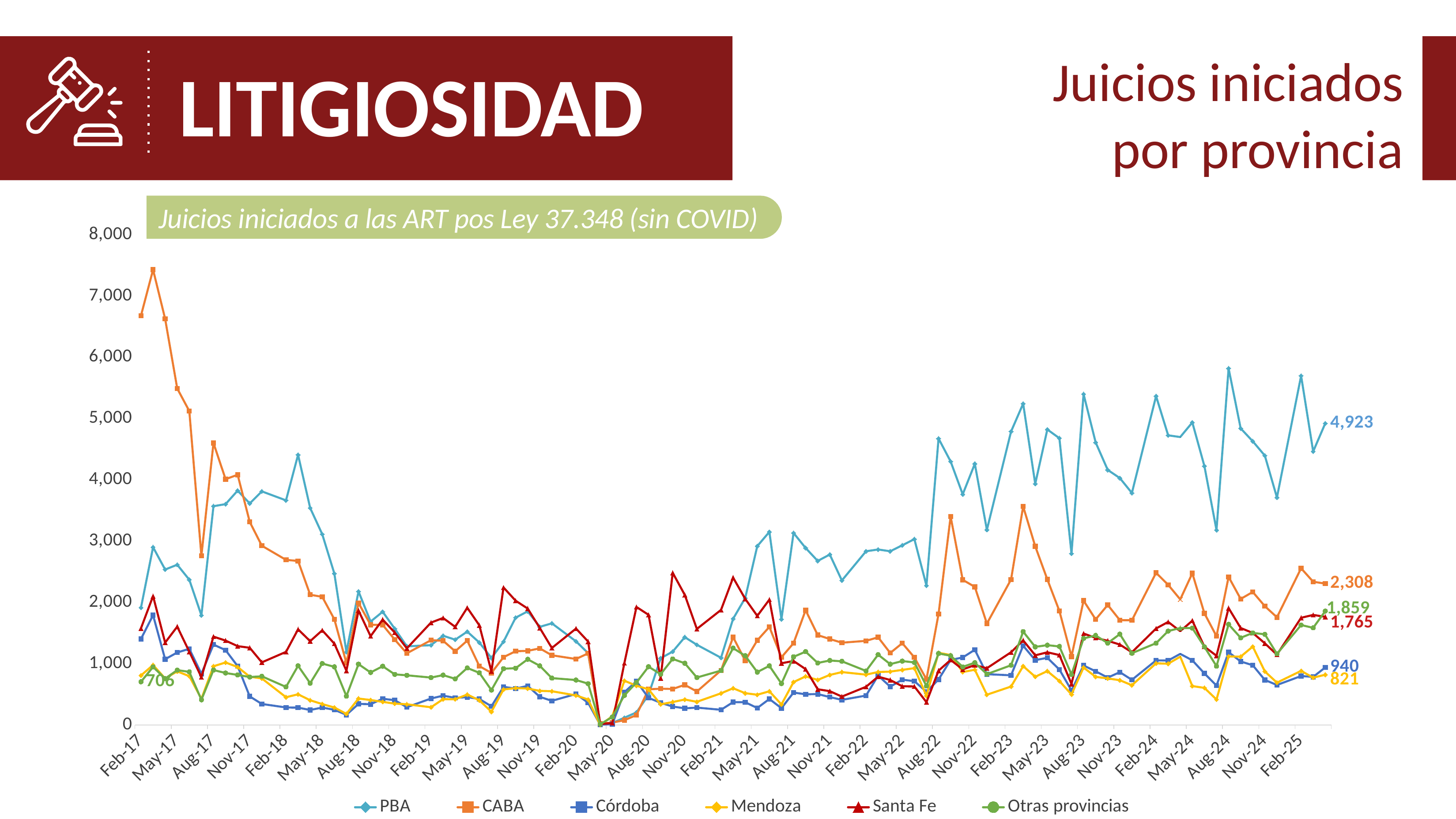
What is the last labelled value for the Mendoza series? 821 What is the difference between the final labelled values of PBA and CABA? 2,615 How many series does the legend list? 6 Which series has the highest value at the final data point? PBA What is the last labelled value for the Otras provincias series? 1,859 Which series has the lowest value at the final data point? Mendoza What is the last labelled value for the Santa Fe series? 1,765 What is the labelled value for Otras provincias at Feb-17? 706 What is the last labelled value for the CABA series? 2,308 At the final data point, which is larger: Santa Fe or Otras provincias? Otras provincias What is the last labelled value for the PBA series? 4,923 Is the value for CABA at Feb-17 greater or less than 6,000? greater